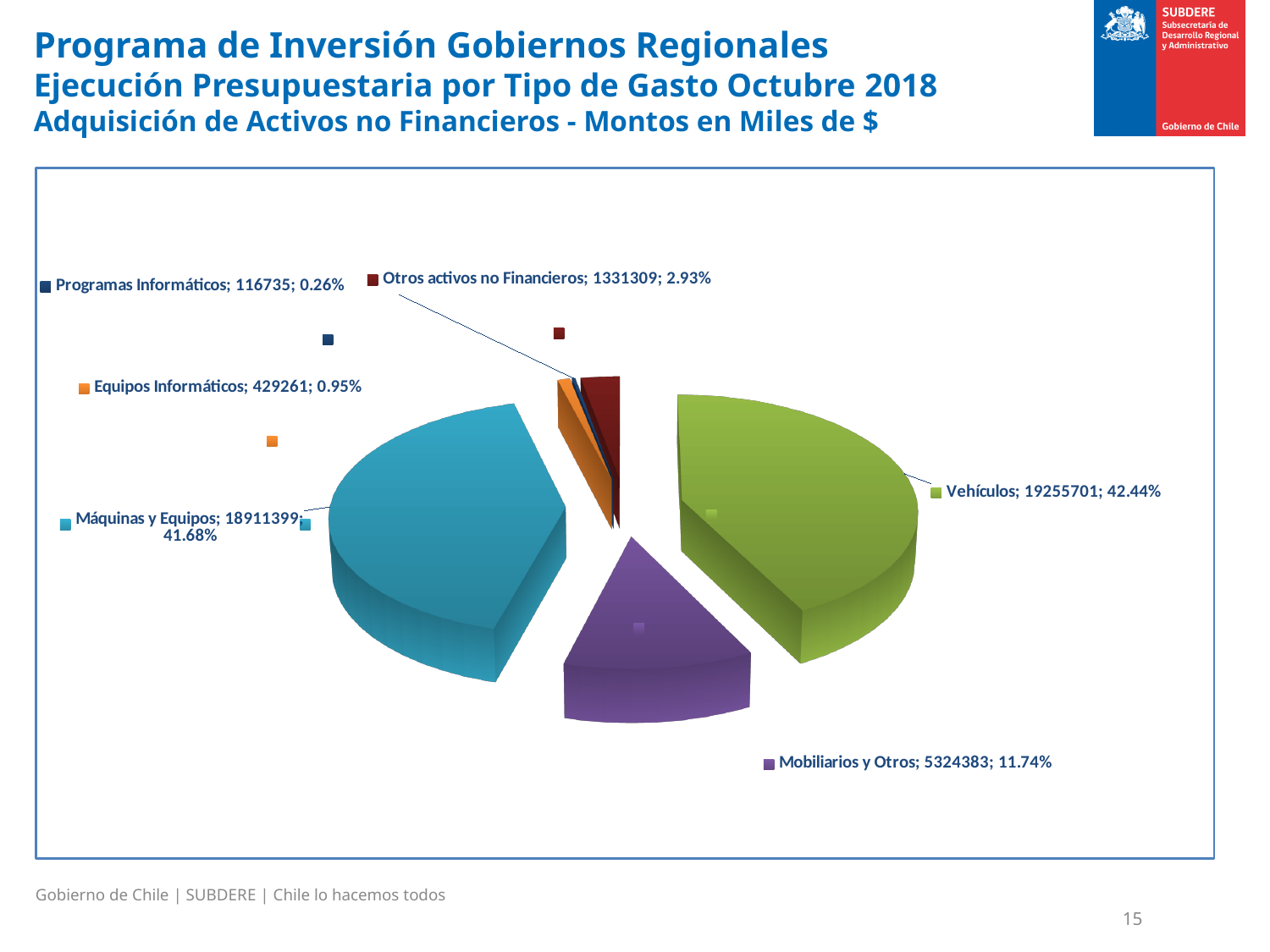
What is the value for Otros activos no Financieros? 1331309 What is the value for Vehículos? 19255701 Which category has the smallest share of the pie? Programas Informáticos Which category has the largest share of the pie? Vehículos What is the difference between the values for Vehículos and Máquinas y Equipos? 344302 What is the value for Máquinas y Equipos? 18911399 What share of the pie does Mobiliarios y Otros represent? 11.74% Which is larger, the value for Equipos Informáticos or the value for Programas Informáticos? Equipos Informáticos What type of chart is shown on the slide? Pie chart What is the value for Mobiliarios y Otros? 5324383 What share of the pie does Equipos Informáticos represent? 0.95% How many slices does the pie chart have? 6